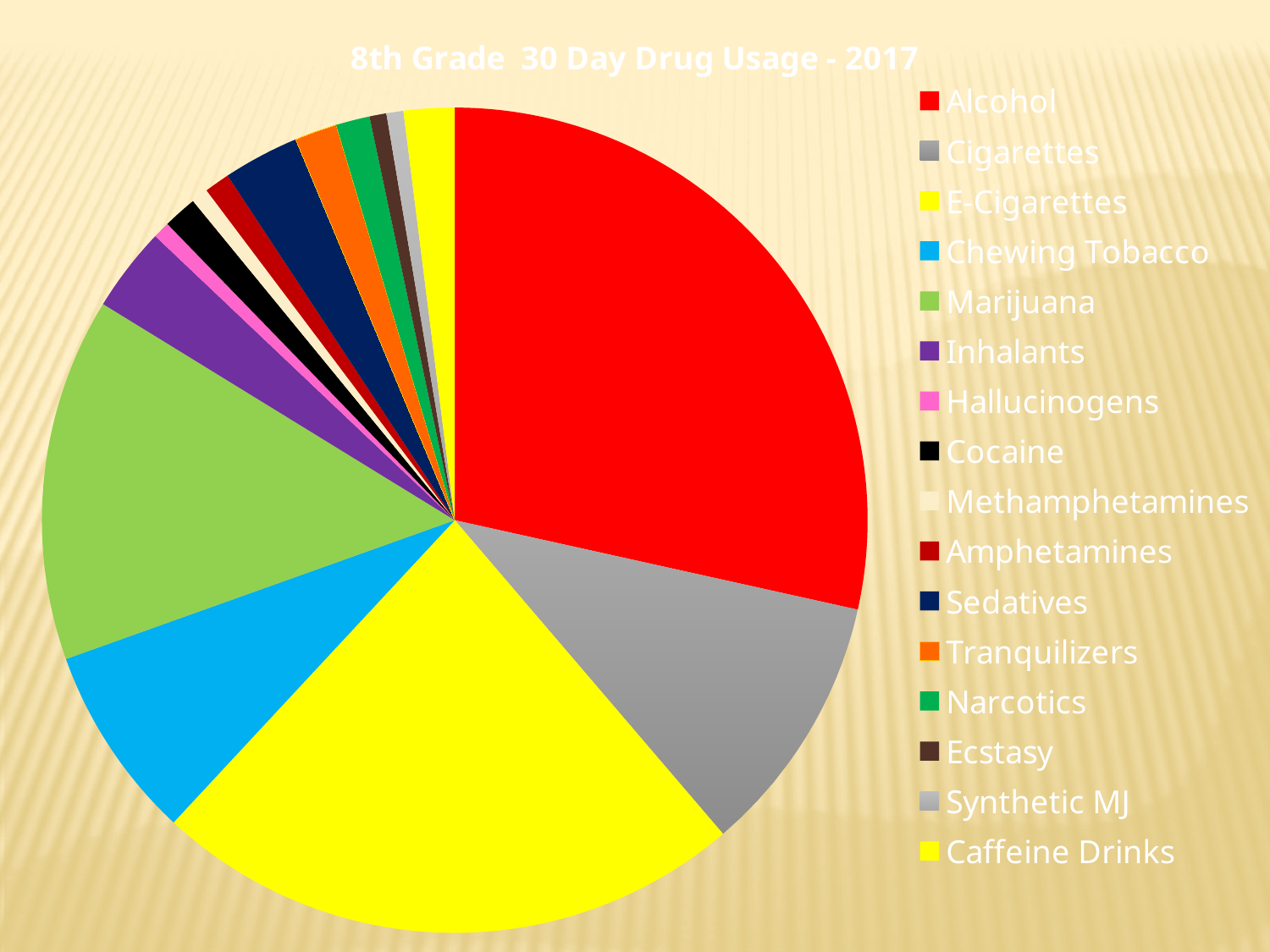
Which slice is larger, Marijuana or Inhalants? Marijuana Which slice is larger, Alcohol or Marijuana? Alcohol Which category has the largest slice of the pie? Alcohol Which slice is larger, Alcohol or Cigarettes? Alcohol What kind of chart is shown on the slide? pie chart What is the title of the chart? 8th Grade 30 Day Drug Usage - 2017 What colour represents Alcohol in the legend? red How many categories does the legend of the pie chart list? 16